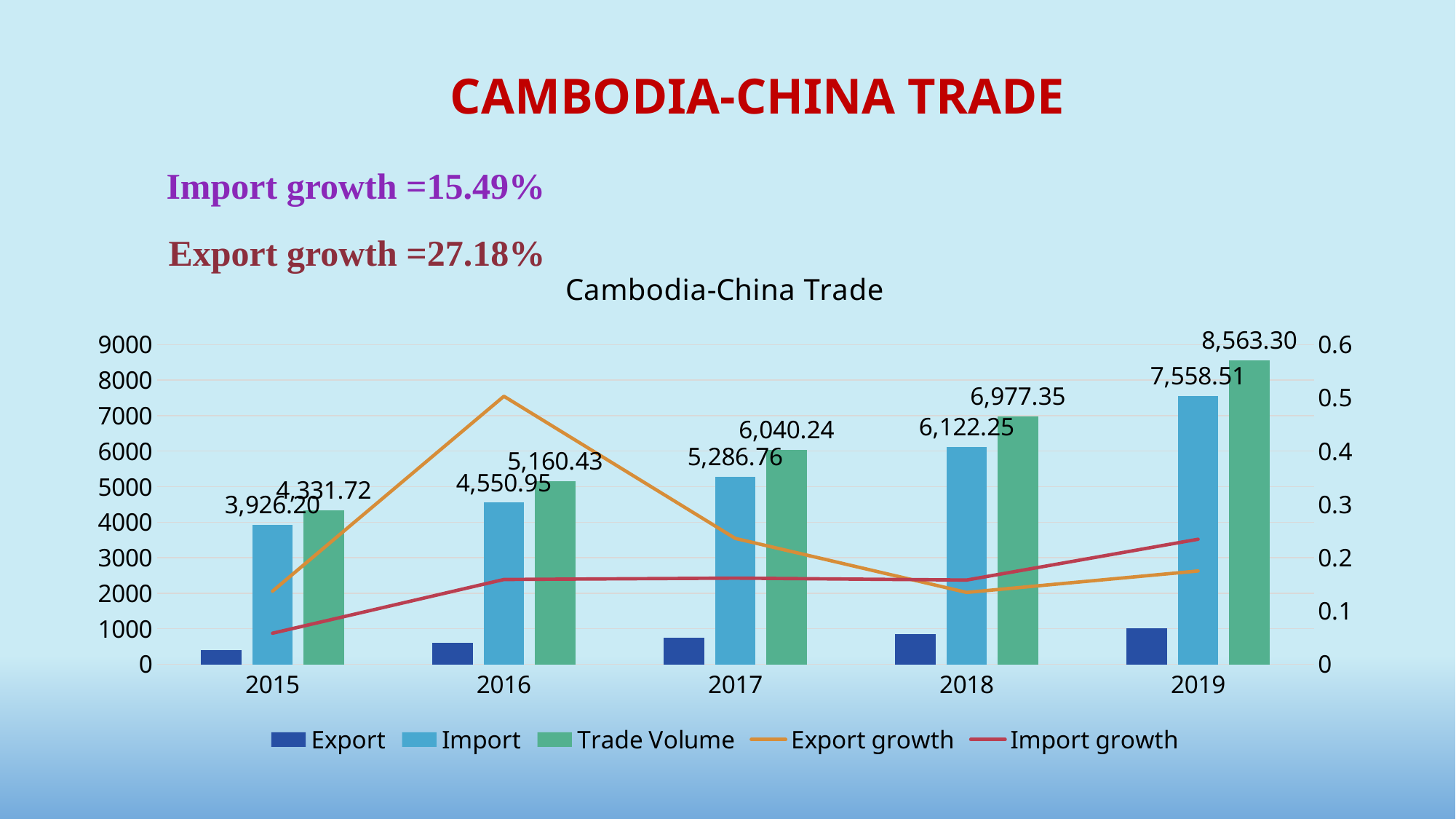
How many series does the legend list? 5 In which year is the Trade Volume highest? 2019 How many years are shown on the x axis? 5 Is the Export growth value for 2016 greater or less than 0.4 on the right axis? greater Is the Export value for 2019 greater or less than 2000? less What is the Import value for 2015? 3,926.20 What is the difference between the Trade Volume and the Import value in 2019? 1,004.79 What is the Trade Volume for 2018? 6,977.35 Does the Import value rise or fall from 2015 to 2019? rise Which is larger, the Import value in 2018 or the Trade Volume in 2017? Import value in 2018 In which year is the Import value lowest? 2015 What is the Import value for 2017? 5,286.76